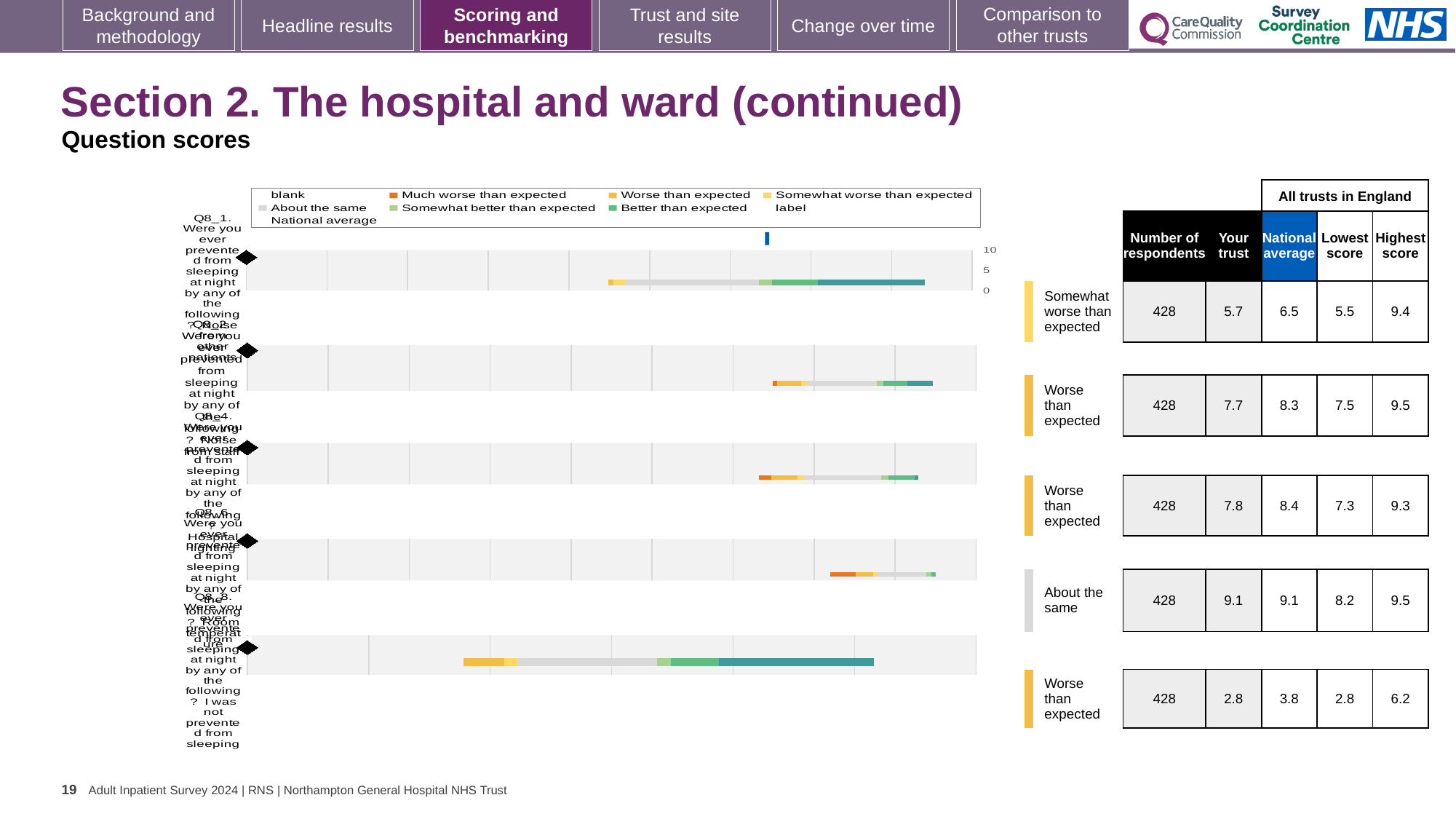
What is the difference between the national average and the 'Your trust' score for the row rated 'Somewhat worse than expected'? 0.8 Which row in the table has the highest 'Your trust' score? About the same (9.1) How many respondents are listed for each question in the table? 428 In the table, what is the 'Your trust' score for the row rated 'Somewhat worse than expected'? 5.7 What kind of chart is shown on the left of the slide? bar chart What is the main title of the slide? Section 2. The hospital and ward (continued) In the table, what is the national average for the row rated 'About the same'? 9.1 How many question rows (bars) are plotted in the chart? 5 In the table, what is the highest score for the bottom row (rated 'Worse than expected', your trust 2.8)? 6.2 For the bottom row of the table, which is larger: the 'Your trust' score or the national average? national average Which row in the table has the lowest 'Your trust' score? the bottom row, Worse than expected (2.8) In the chart legend, what colour represents 'About the same'? grey